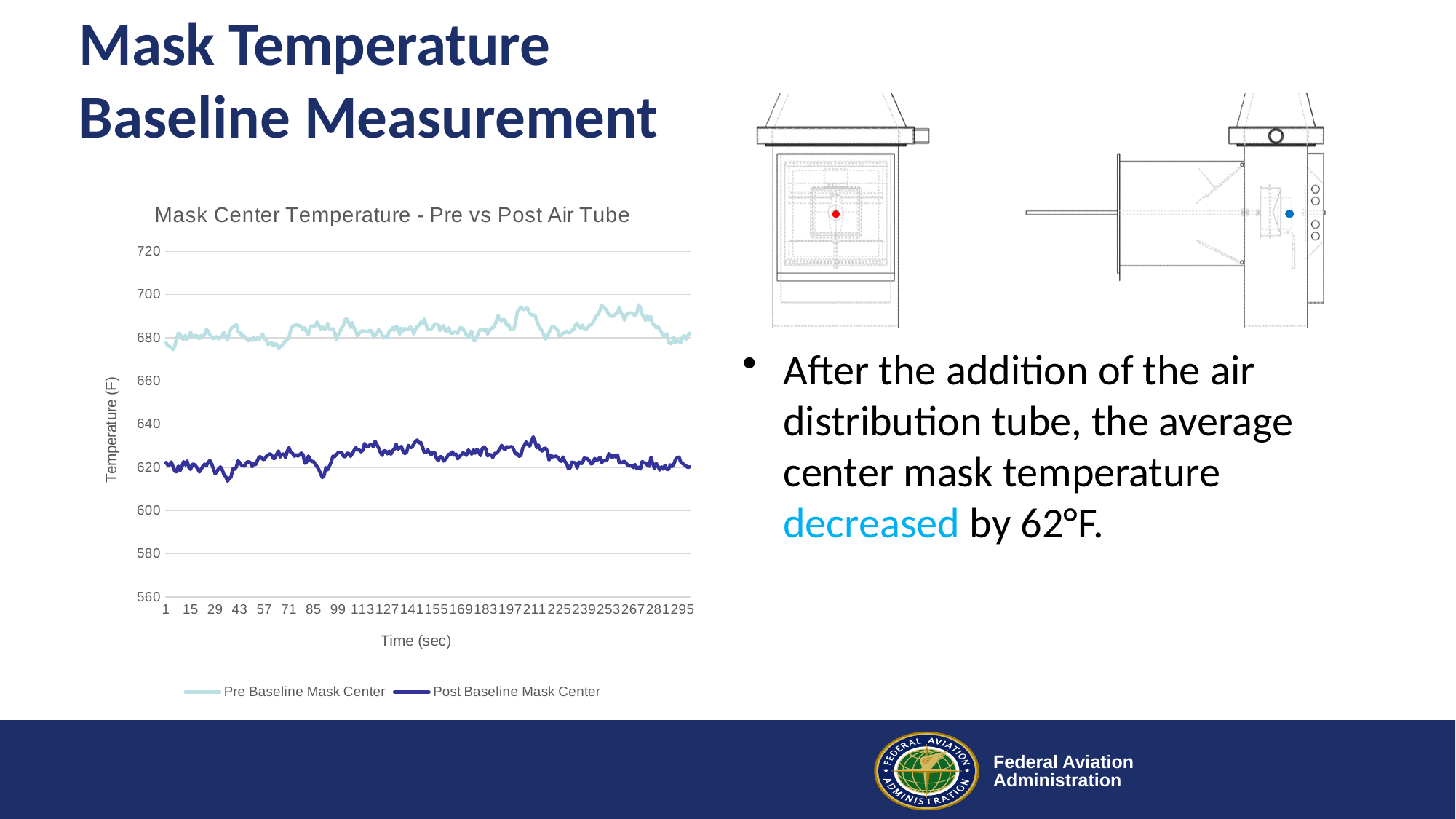
How many series does the chart legend list? 2 Are the values for the Pre Baseline Mask Center series greater or less than 660? greater What are the two series named in the chart legend? Pre Baseline Mask Center and Post Baseline Mask Center Are the values for the Post Baseline Mask Center series greater or less than 600? greater Which series has higher temperature values throughout the chart, Pre Baseline Mask Center or Post Baseline Mask Center? Pre Baseline Mask Center Are the values for the Post Baseline Mask Center series greater or less than 660? less What is the label of the y axis of the chart? Temperature (F) What is the label of the x axis of the chart? Time (sec) What type of chart is shown on the slide? Line chart